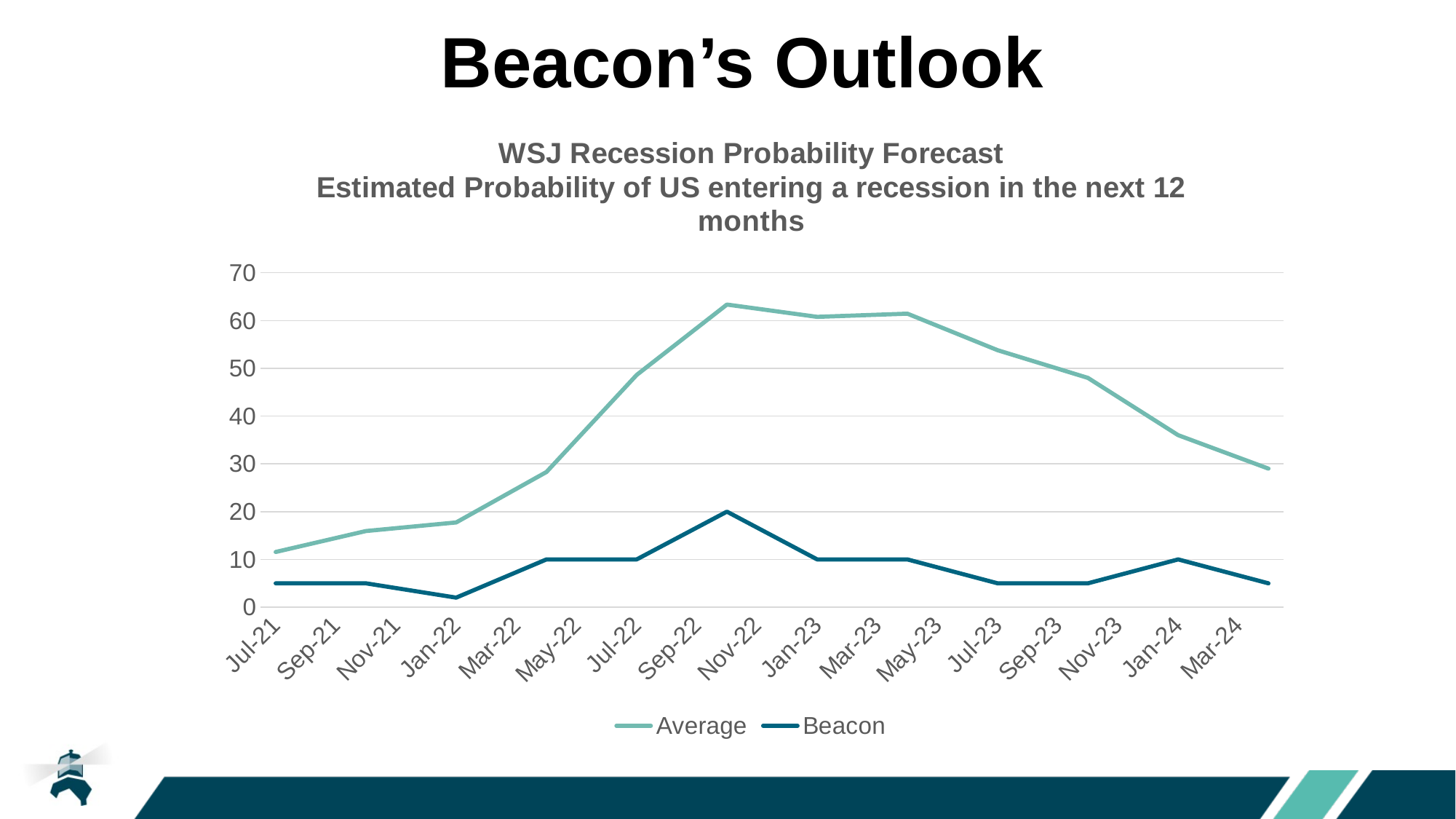
Which series has the larger value at Sep-22, Average or Beacon? Average What kind of chart is shown on the slide? line chart Is the Average value at Nov-22 greater or less than 60? greater How many dates are labelled along the x axis? 17 Does the Average series rise or fall between Nov-22 and Mar-24? fall How many series does the legend list? 2 What is the Beacon value at Mar-23? 10 At which date does the Beacon series reach its lowest value? Jan-22